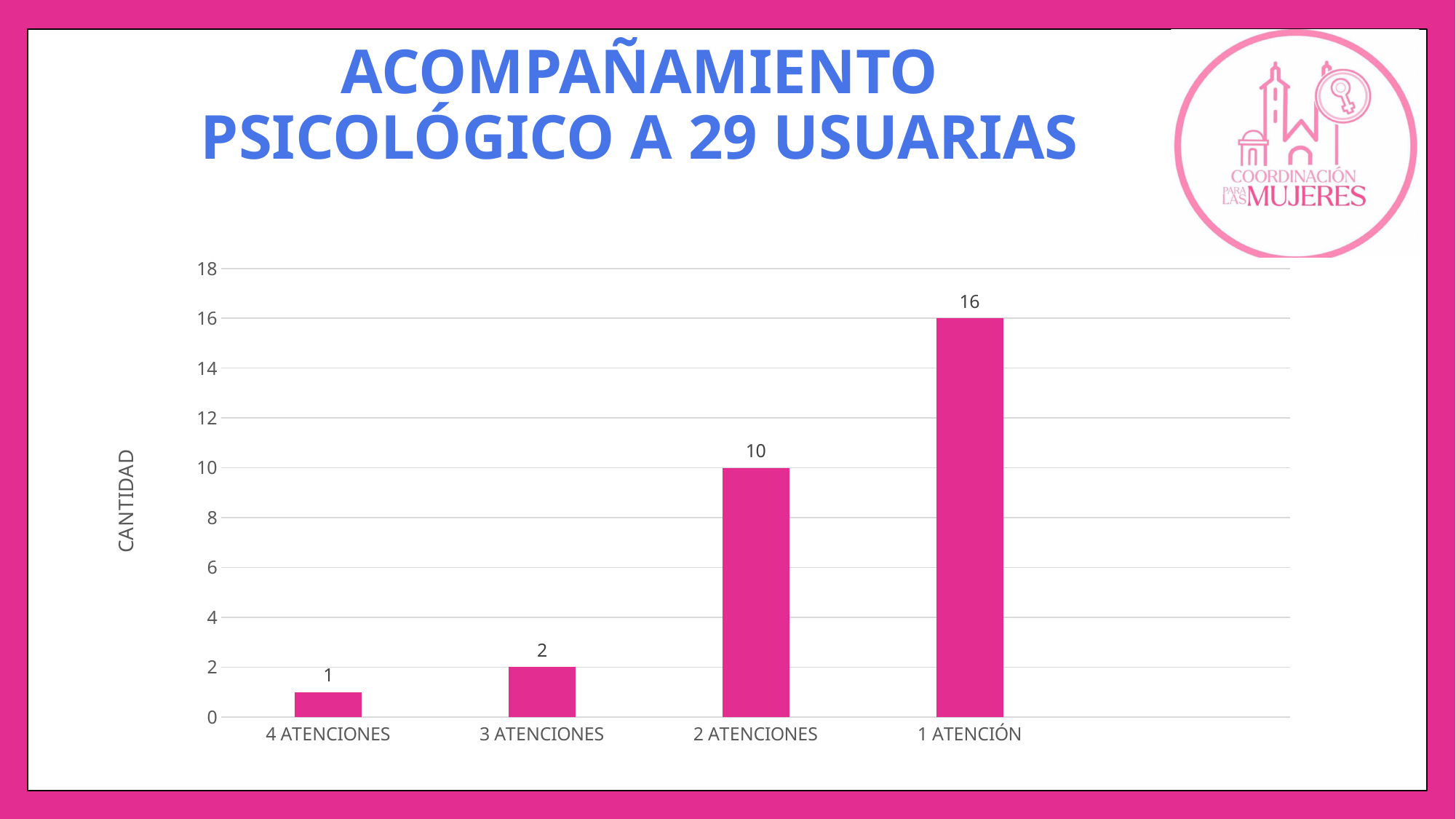
What is the value for 4 ATENCIONES? 1 What is the label of the vertical axis? CANTIDAD Which category has the highest value? 1 ATENCIÓN What is the value for 2 ATENCIONES? 10 What is the difference between the values for 1 ATENCIÓN and 2 ATENCIONES? 6 What is the value for 1 ATENCIÓN? 16 Which is larger, the value for 3 ATENCIONES or the value for 2 ATENCIONES? 2 ATENCIONES How many categories are shown on the x axis? 4 Is the value for 1 ATENCIÓN greater or less than 14? greater Which category has the lowest value? 4 ATENCIONES What is the value for 3 ATENCIONES? 2 What kind of chart is shown on the slide? bar chart